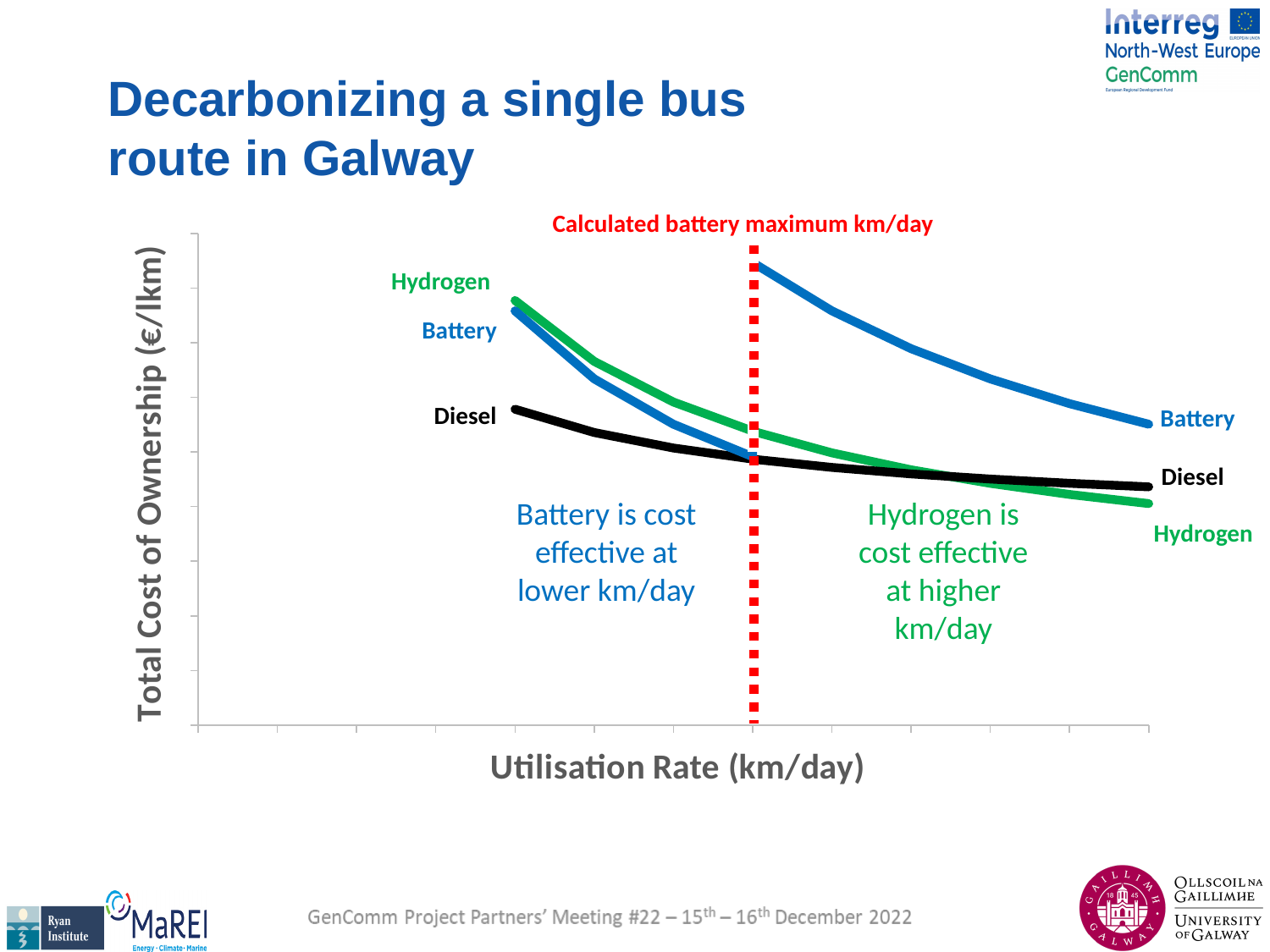
Which series has the lowest total cost of ownership at the left-hand end of the chart? Diesel At the right-hand end of the chart, which is higher: the Battery line or the Diesel line? Battery Does the Hydrogen line rise or fall as the utilisation rate increases? Fall How many series (lines) are plotted on the chart? 3 At the left-hand end of the chart, which is higher: the Hydrogen line or the Diesel line? Hydrogen What kind of chart is shown on the slide? Line chart What is the title of the x axis? Utilisation Rate (km/day) Which series has the highest total cost of ownership at the right-hand end of the chart? Battery What does the red dashed vertical line represent? Calculated battery maximum km/day What is the title of the y axis? Total Cost of Ownership (€/lkm) Does the Diesel line rise or fall as the utilisation rate increases? Fall Which series has the lowest total cost of ownership at the right-hand end of the chart? Hydrogen